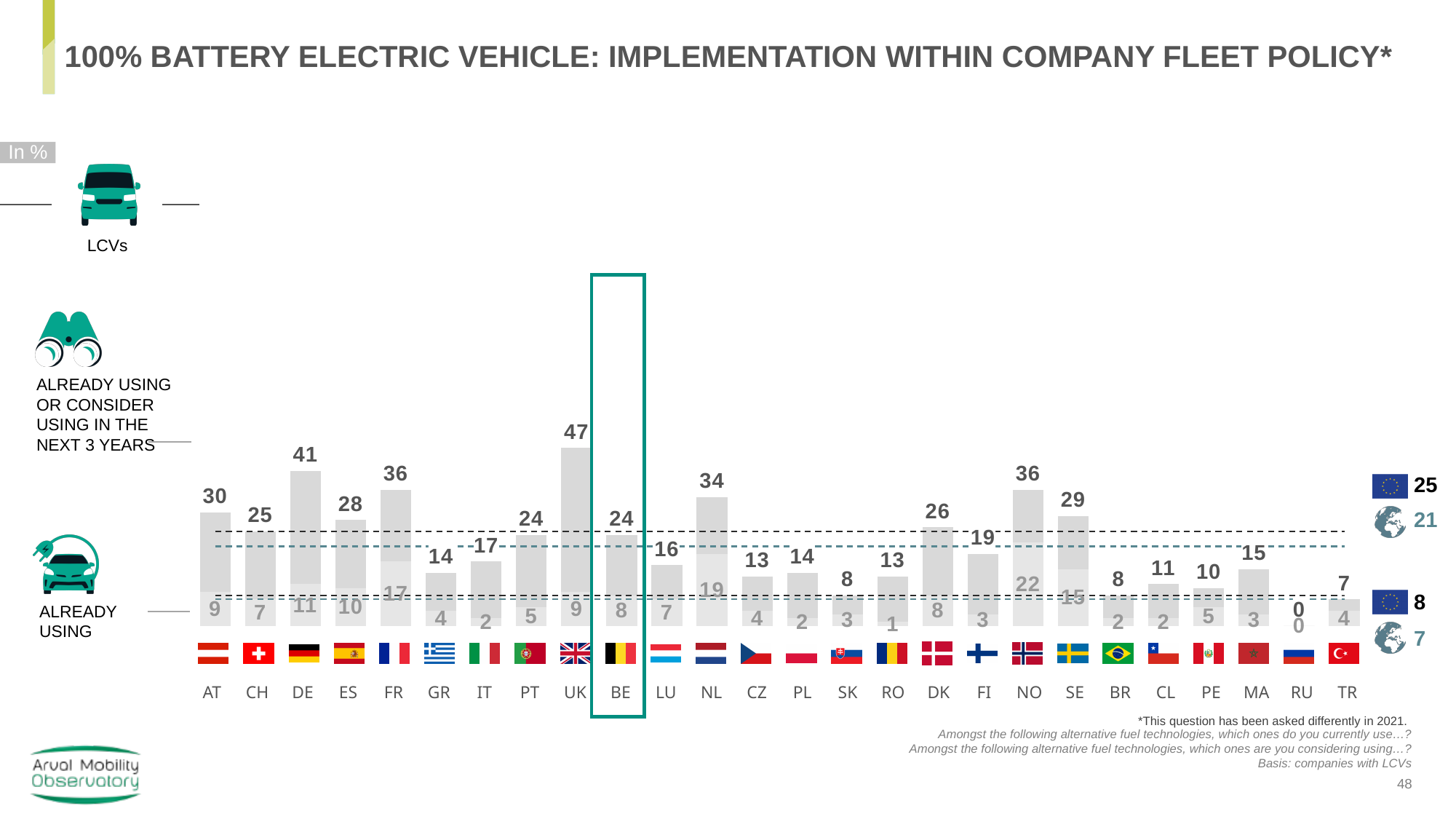
Which country's bar is highlighted with a teal rectangle on the chart? BE What is the 'already using or consider using in the next 3 years' value for UK? 47 What kind of chart is shown on the slide? bar chart Which country has the lowest value for 'already using or consider using in the next 3 years'? RU What is the global average for 'already using or consider using in the next 3 years' shown at the right of the chart? 21 How many countries are shown on the x axis of the chart? 26 Which country has the larger 'already using' value, NL or SE? NL What is the European average for 'already using' shown at the right of the chart? 8 What is the 'already using' value for NO? 22 What is the 'already using or consider using in the next 3 years' value for BE? 24 What is the difference between the 'already using or consider using in the next 3 years' values for DE and FR? 5 Which country has the highest value for 'already using or consider using in the next 3 years'? UK